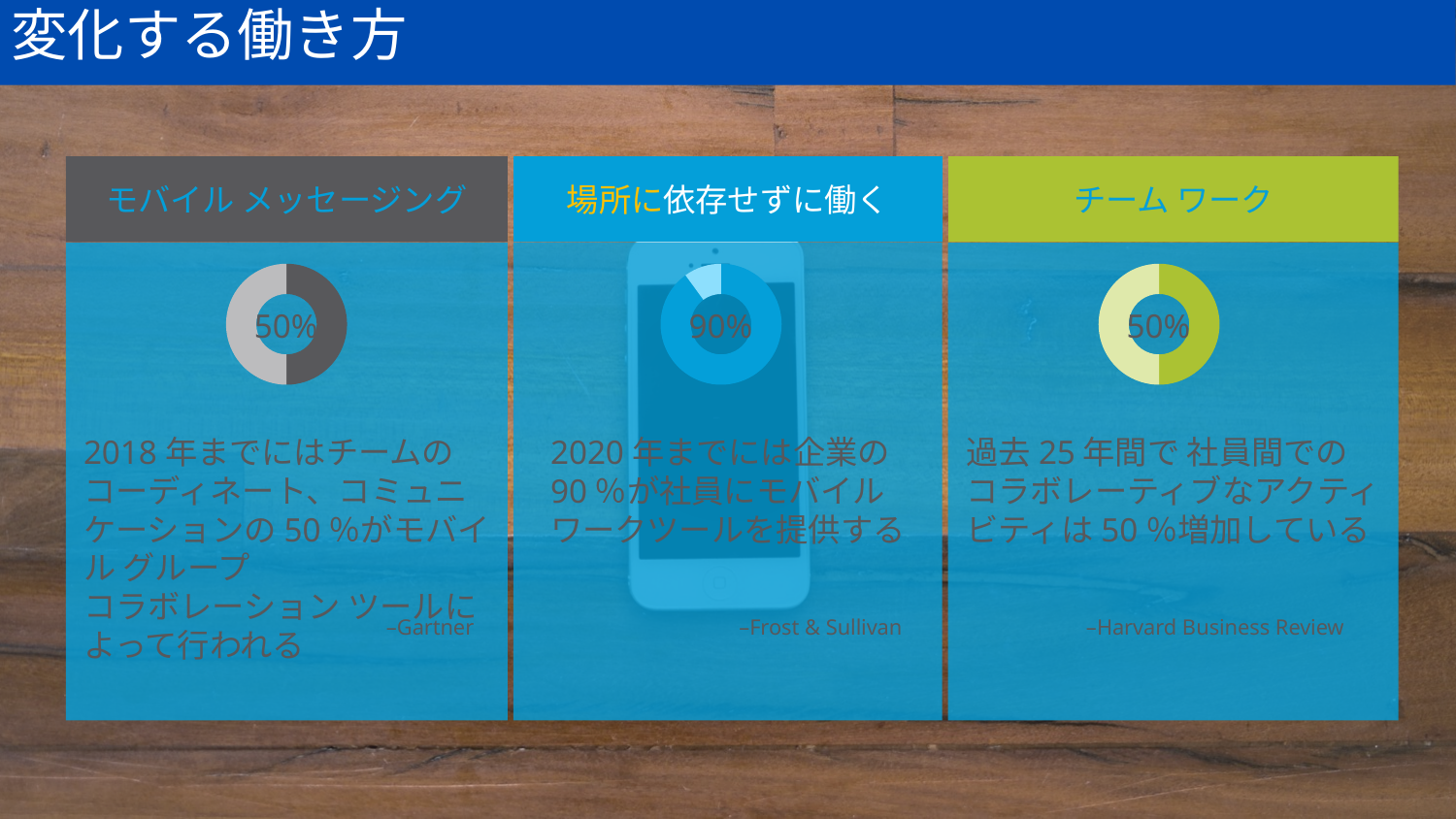
Is the value in the 場所に依存せずに働く donut chart greater or less than 50%? greater How many donut charts are shown on the slide? 3 What value is shown in the centre of the donut chart under the チーム ワーク panel? 50% Is the percentage in the 場所に依存せずに働く donut chart larger or smaller than the percentage in the モバイル メッセージング donut chart? Larger Which source is cited beneath the チーム ワーク donut chart? Harvard Business Review Which source is cited beneath the 場所に依存せずに働く donut chart? Frost & Sullivan What kind of chart is used in each of the three panels on the slide? Donut chart Which panel's donut chart shows the highest percentage? 場所に依存せずに働く What value is shown in the centre of the donut chart under the モバイル メッセージング panel? 50% What value is shown in the centre of the donut chart under the 場所に依存せずに働く panel? 90% What is the difference between the percentage in the 場所に依存せずに働く donut chart and the percentage in the チーム ワーク donut chart? 40%